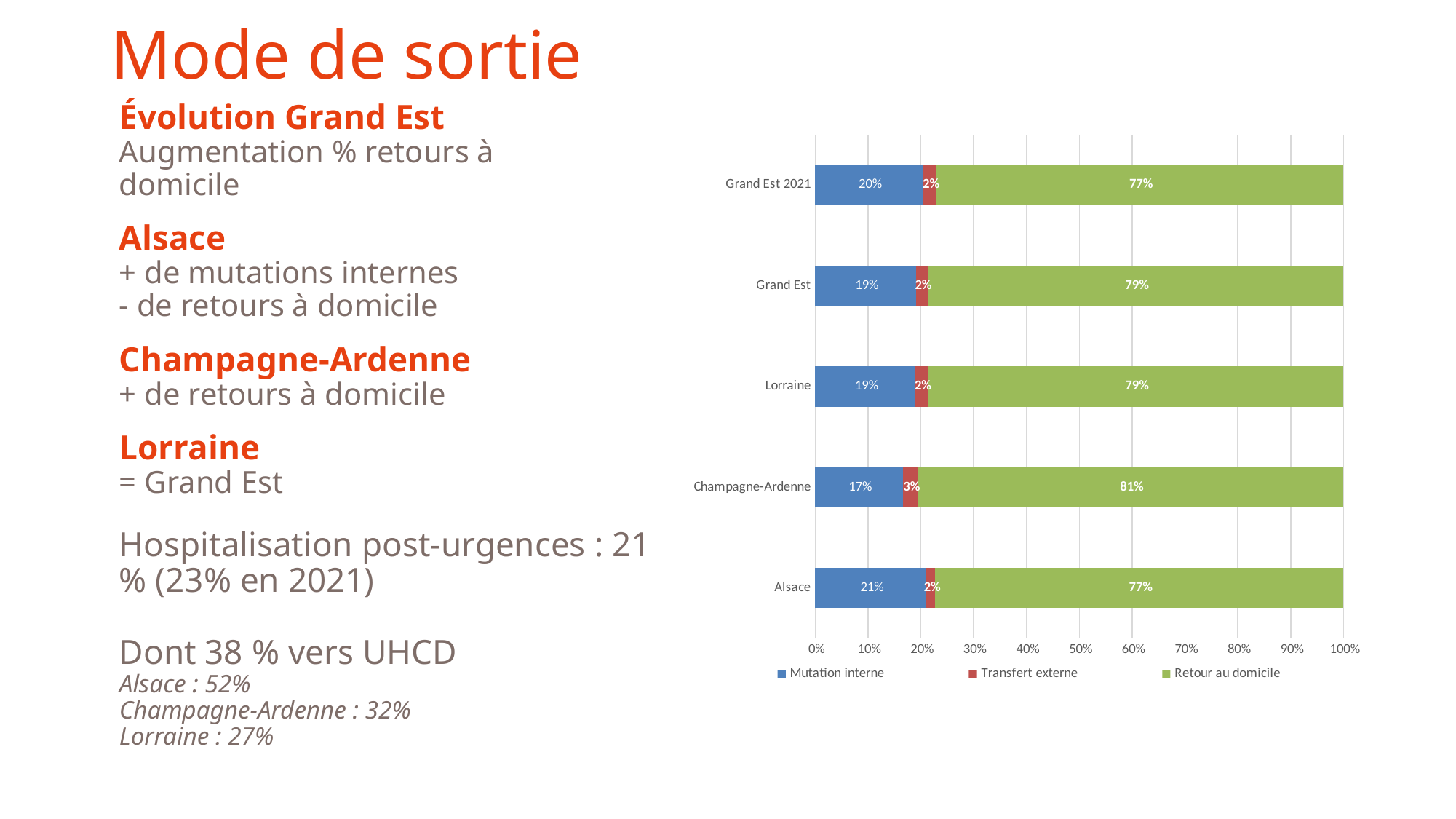
What is the Transfert externe value for Champagne-Ardenne? 3% Which colour represents Transfert externe in the chart? Red What kind of chart is shown on the slide? Stacked bar chart Which category has the highest Retour au domicile value? Champagne-Ardenne Which is larger, the Retour au domicile value for Lorraine or for Alsace? Lorraine What is the Retour au domicile value for Grand Est 2021? 77% What is the difference between the Mutation interne values for Alsace and Champagne-Ardenne? 4% What is the Mutation interne value for Alsace? 21% How many categories are shown on the chart? 5 How many series does the legend list? 3 Which category has the lowest Mutation interne value? Champagne-Ardenne What is the Retour au domicile value for Champagne-Ardenne? 81%